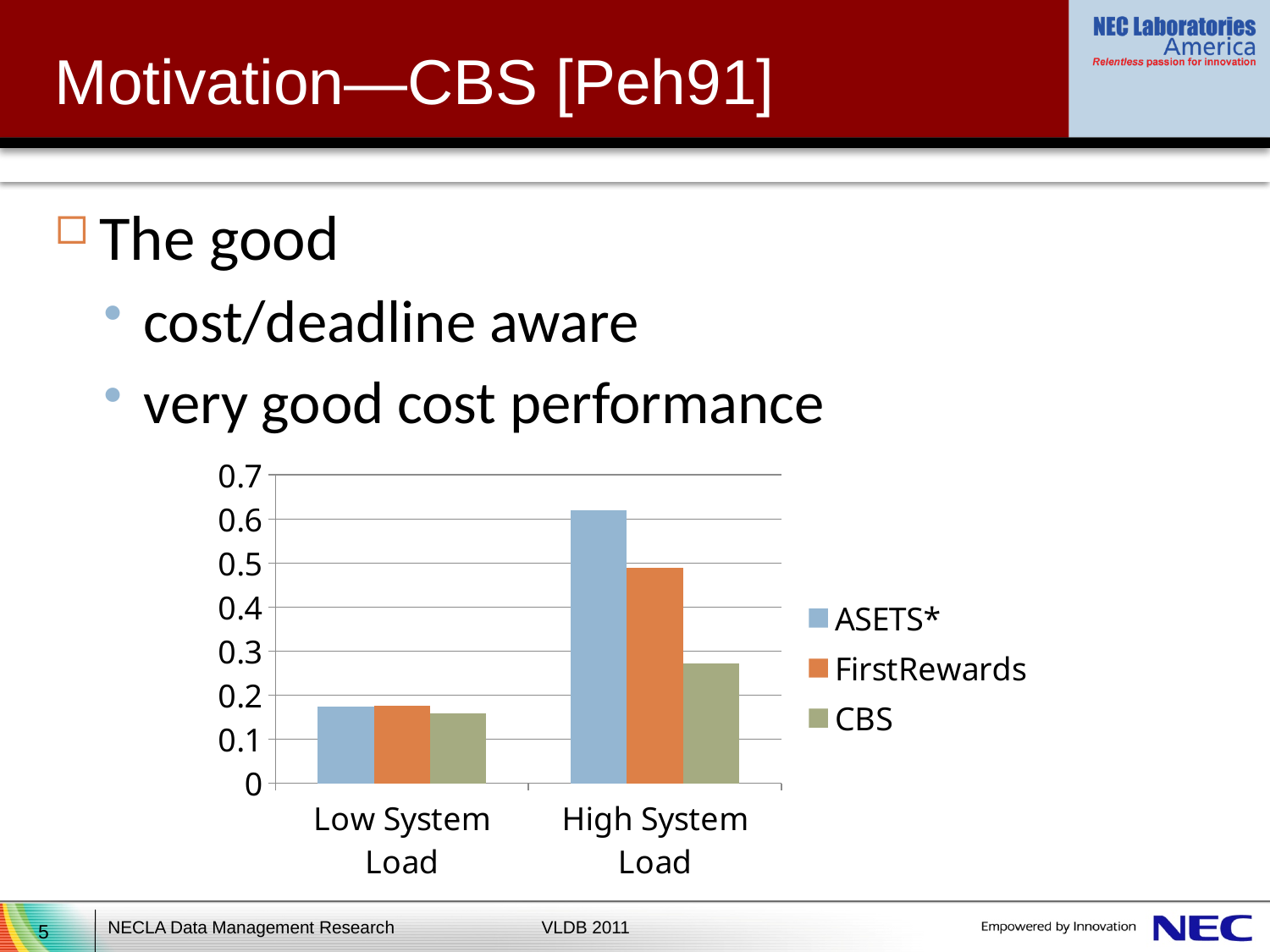
Which series is shown in orange in the chart legend? FirstRewards Under Low System Load, is the value for CBS greater or less than 0.2? less Which series has the highest value under High System Load? ASETS* How many categories are shown on the x axis of the chart? 2 Which series has the lowest value under High System Load? CBS Does the value for CBS rise or fall from Low System Load to High System Load? rise Under High System Load, which is larger: the value for FirstRewards or the value for CBS? FirstRewards How many series does the chart legend list? 3 Under High System Load, is the value for ASETS* greater or less than 0.5? greater Under High System Load, is the value for FirstRewards greater or less than 0.4? greater What kind of chart is shown on the slide? bar chart